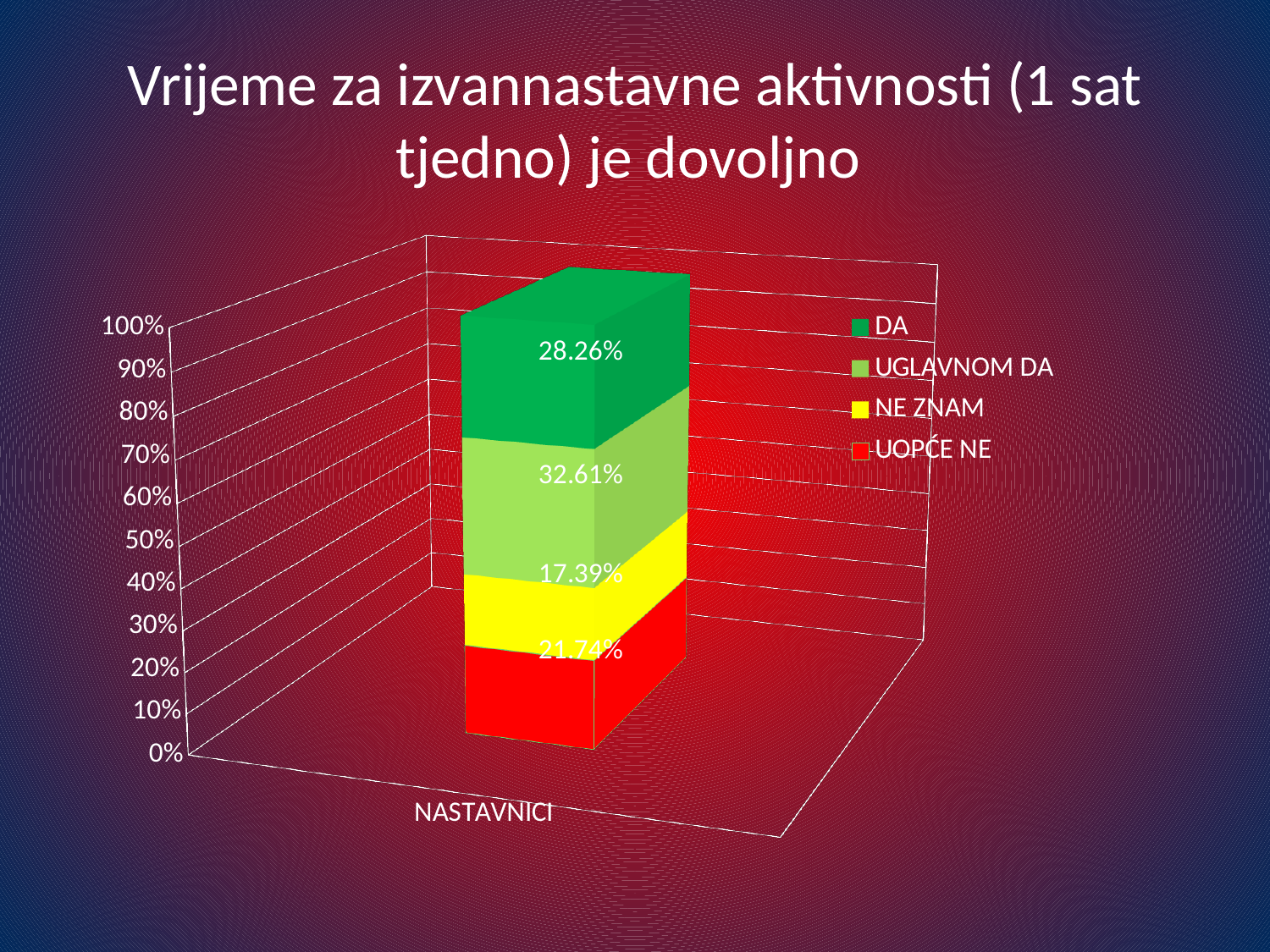
Which series has the lowest value for NASTAVNICI? NE ZNAM What kind of chart is shown on the slide? Stacked bar chart Which series has the highest value for NASTAVNICI? UGLAVNOM DA What is the value for NE ZNAM for NASTAVNICI? 17.39% What is the value for UGLAVNOM DA for NASTAVNICI? 32.61% What is the value for DA for NASTAVNICI? 28.26% What is the total of the stacked bar for NASTAVNICI? 100% How many categories are shown on the x axis? 1 What is the difference between the UGLAVNOM DA and DA values for NASTAVNICI? 4.35% How many series does the legend list? 4 What is the value for UOPĆE NE for NASTAVNICI? 21.74% Which is larger for NASTAVNICI, UOPĆE NE or NE ZNAM? UOPĆE NE